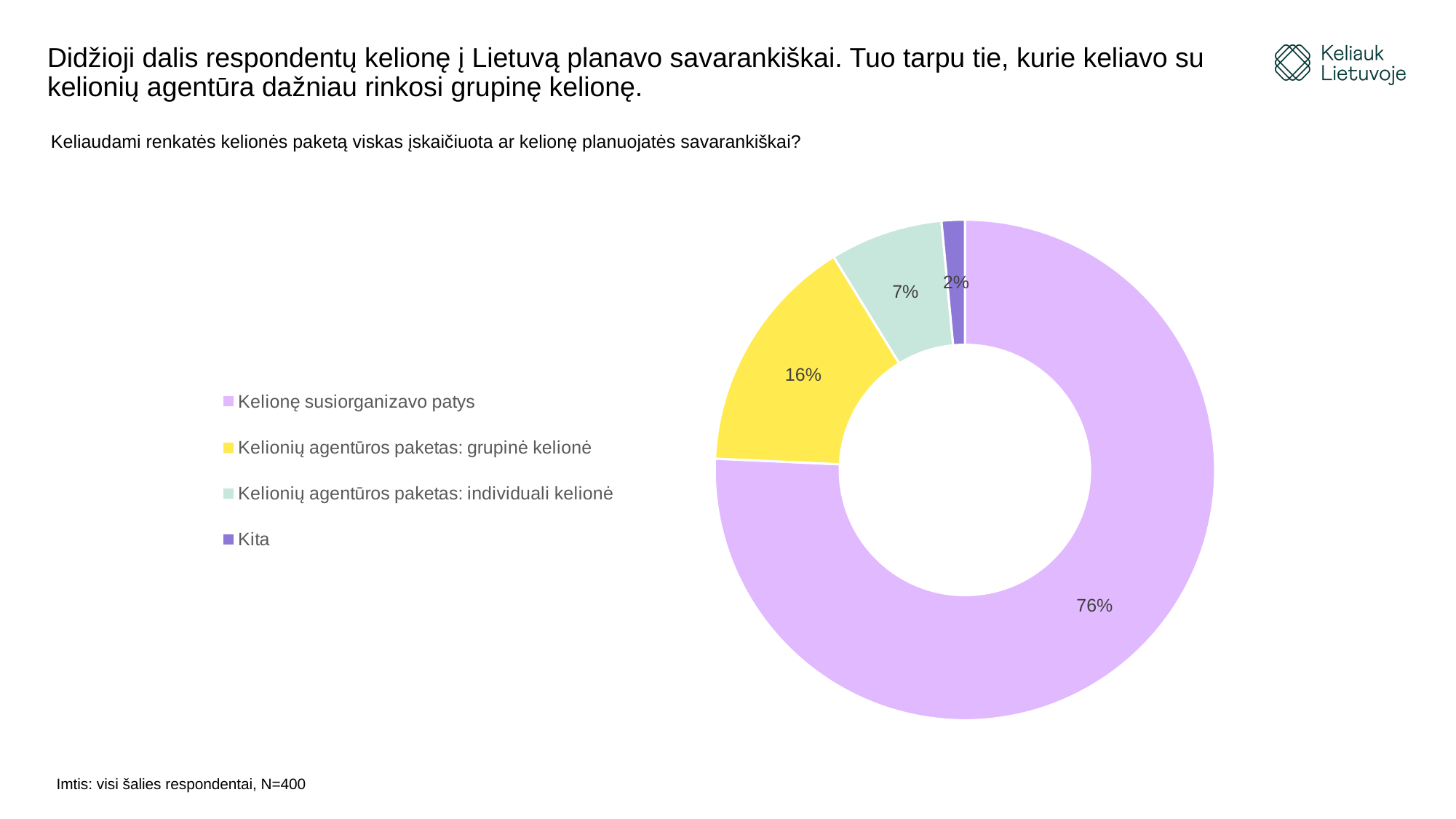
What colour is the slice for "Kelionių agentūros paketas: grupinė kelionė"? Yellow What is the difference in percentage points between "Kelionę susiorganizavo patys" and "Kelionių agentūros paketas: grupinė kelionė"? 60 What share of respondents is shown for "Kelionę susiorganizavo patys"? 76% What share of respondents is shown for "Kita"? 2% What kind of chart is shown on the slide? Pie chart (donut) What share of respondents is shown for "Kelionių agentūros paketas: grupinė kelionė"? 16% Which category has the smallest share in the chart? Kita Which is larger: the share for "Kelionių agentūros paketas: grupinė kelionė" or for "Kelionių agentūros paketas: individuali kelionė"? Kelionių agentūros paketas: grupinė kelionė Which category has the largest share in the chart? Kelionę susiorganizavo patys What share of respondents is shown for "Kelionių agentūros paketas: individuali kelionė"? 7% How many categories does the chart show? 4 What is the difference in percentage points between "Kelionių agentūros paketas: grupinė kelionė" and "Kelionių agentūros paketas: individuali kelionė"? 9